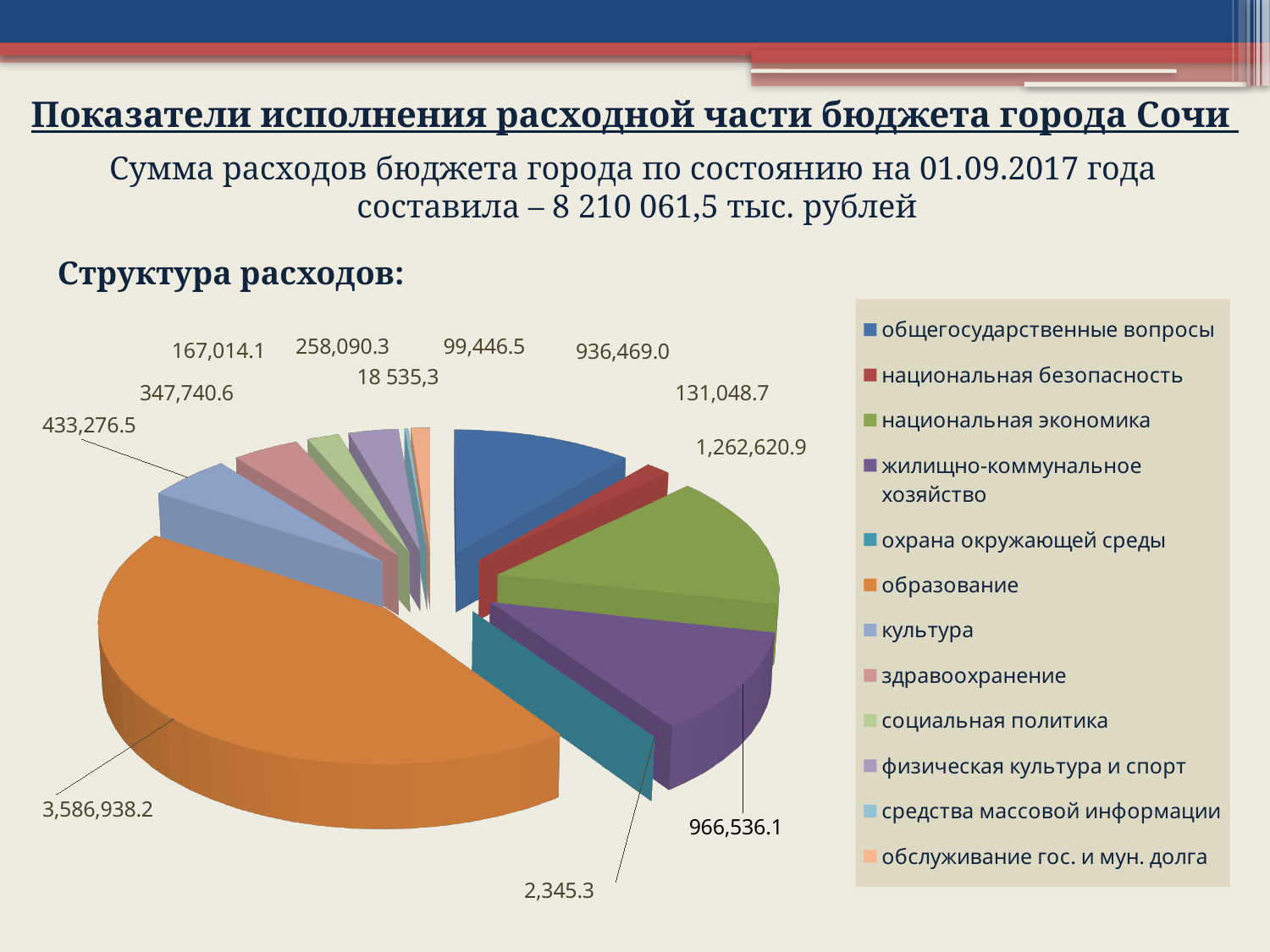
What is the value for образование in the pie chart? 3,586,938.2 Which category has the largest slice in the pie chart? образование What kind of chart is shown on the slide? pie chart Which is larger, the value for национальная экономика or the value for жилищно-коммунальное хозяйство? национальная экономика Which category has the smallest slice in the pie chart? охрана окружающей среды What is the heading printed above the pie chart? Структура расходов: What is the value for культура in the pie chart? 433,276.5 What is the difference between the values for образование and национальная экономика? 2,324,317.3 How many categories does the legend of the pie chart list? 12 What is the value for национальная экономика in the pie chart? 1,262,620.9 What is the value for жилищно-коммунальное хозяйство in the pie chart? 966,536.1 What is the value for общегосударственные вопросы in the pie chart? 936,469.0